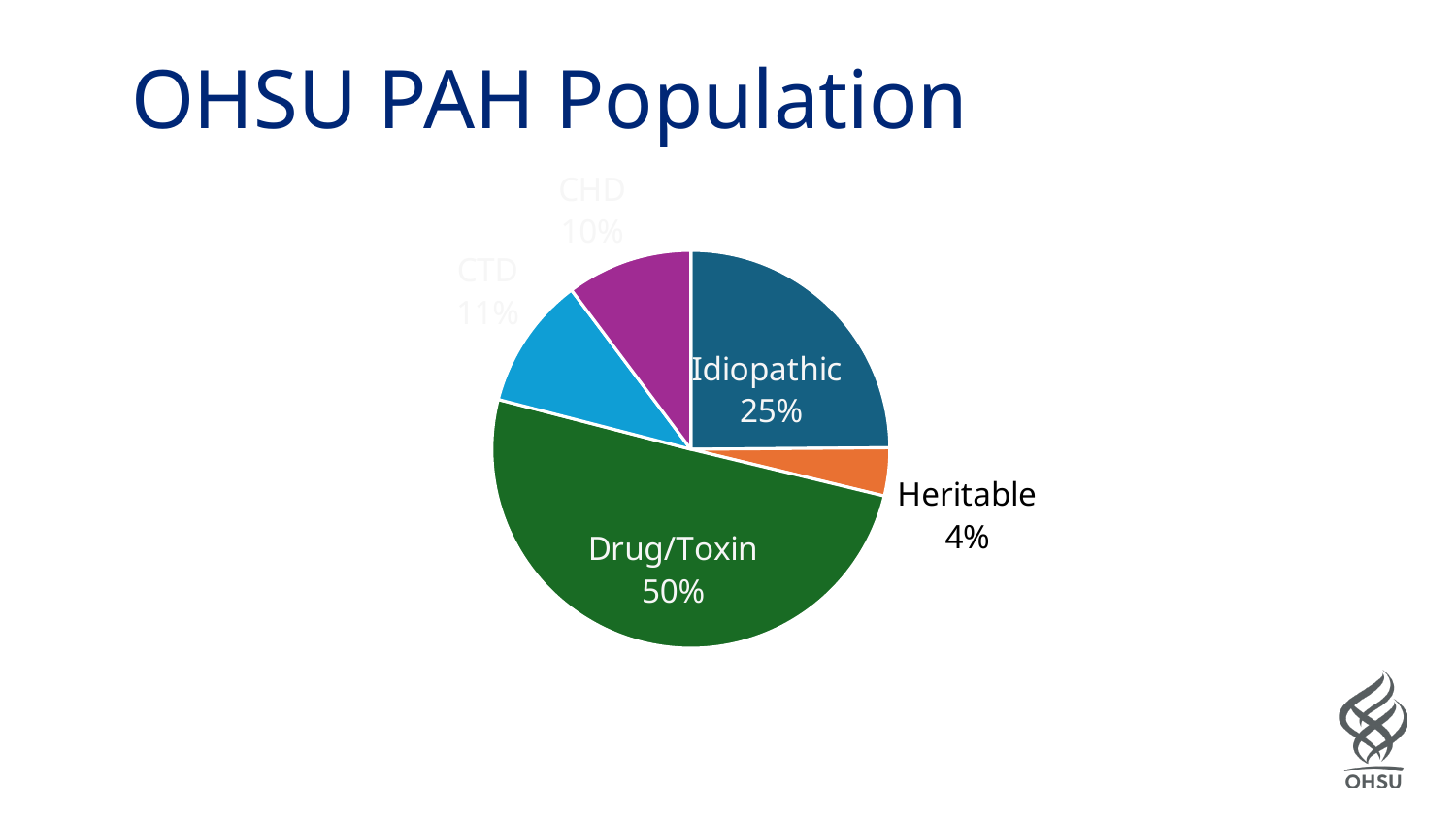
Which category makes up the largest slice of the pie? Drug/Toxin How many percentage points larger is the Idiopathic slice than the Heritable slice? 21 percentage points What percentage of the OHSU PAH population is Idiopathic? 25% How many percentage points larger is the Drug/Toxin slice than the Idiopathic slice? 25 percentage points What kind of chart is shown on the slide? Pie chart What colour is the Drug/Toxin slice? Green How many slices does the pie chart have? 5 Which category makes up the smallest slice of the pie? Heritable What percentage of the OHSU PAH population is Heritable? 4% What percentage of the OHSU PAH population is Drug/Toxin? 50% Which is larger, the Idiopathic slice or the Heritable slice? Idiopathic What is the title of the slide containing the pie chart? OHSU PAH Population